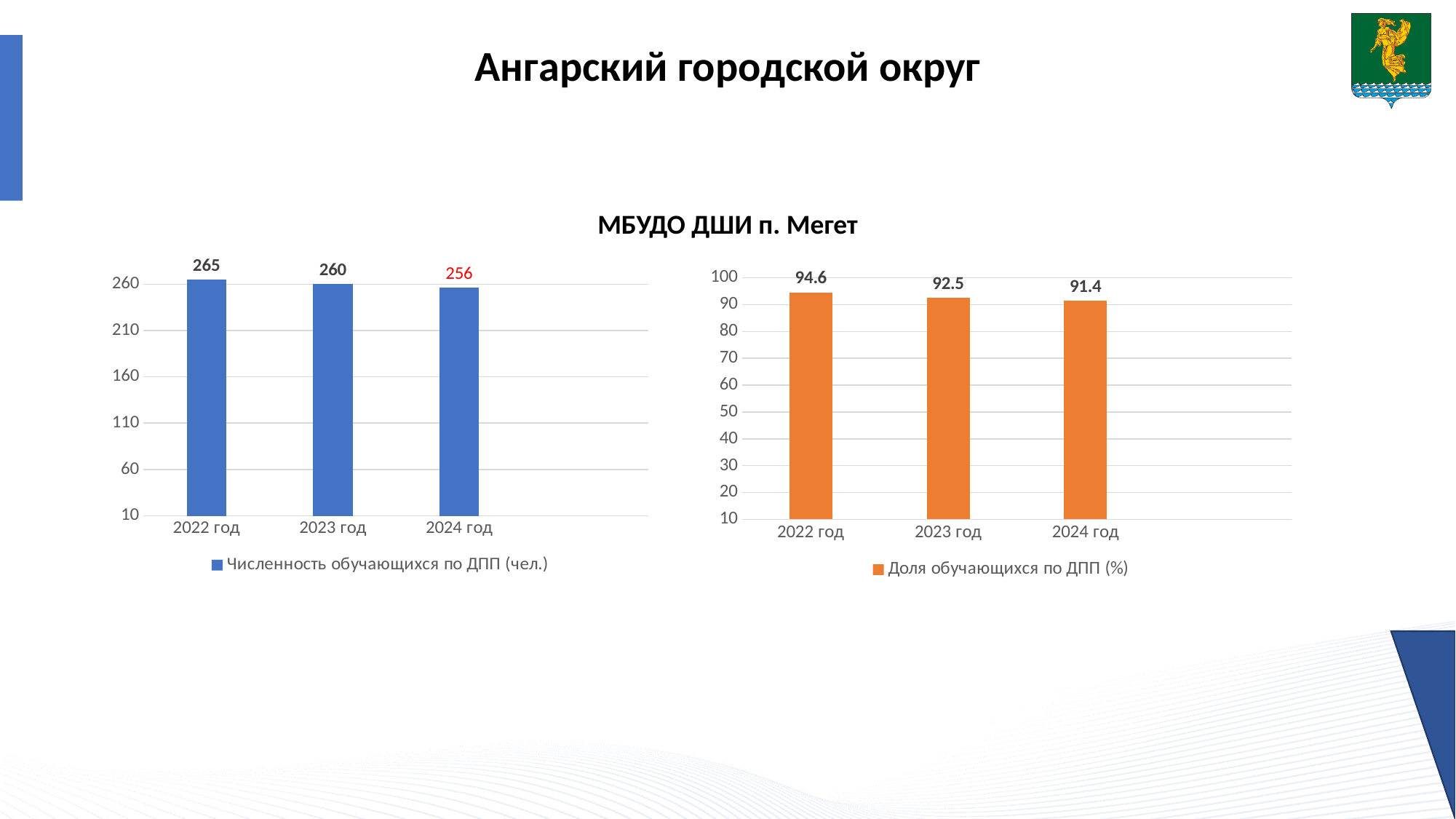
In the left chart (Численность обучающихся по ДПП), what is the value for 2022 год? 265 In the left chart (Численность обучающихся по ДПП), is the value for 2023 год greater or less than 210? greater How many years are shown on the x axis of the right chart (Доля обучающихся по ДПП)? 3 In the left chart (Численность обучающихся по ДПП), what is the difference between the values for 2022 год and 2024 год? 9 In the right chart (Доля обучающихся по ДПП), which year has the lowest value? 2024 год In the right chart (Доля обучающихся по ДПП), what is the difference between the values for 2022 год and 2023 год? 2.1 In the left chart (Численность обучающихся по ДПП), which year has the highest value? 2022 год In the right chart (Доля обучающихся по ДПП), what is the value for 2024 год? 91.4 In the right chart (Доля обучающихся по ДПП), do the values rise or fall from 2022 год to 2024 год? fall In the right chart (Доля обучающихся по ДПП), what is the value for 2023 год? 92.5 In the left chart (Численность обучающихся по ДПП), what is the value for 2024 год? 256 What kind of chart is the left chart (Численность обучающихся по ДПП)? bar chart